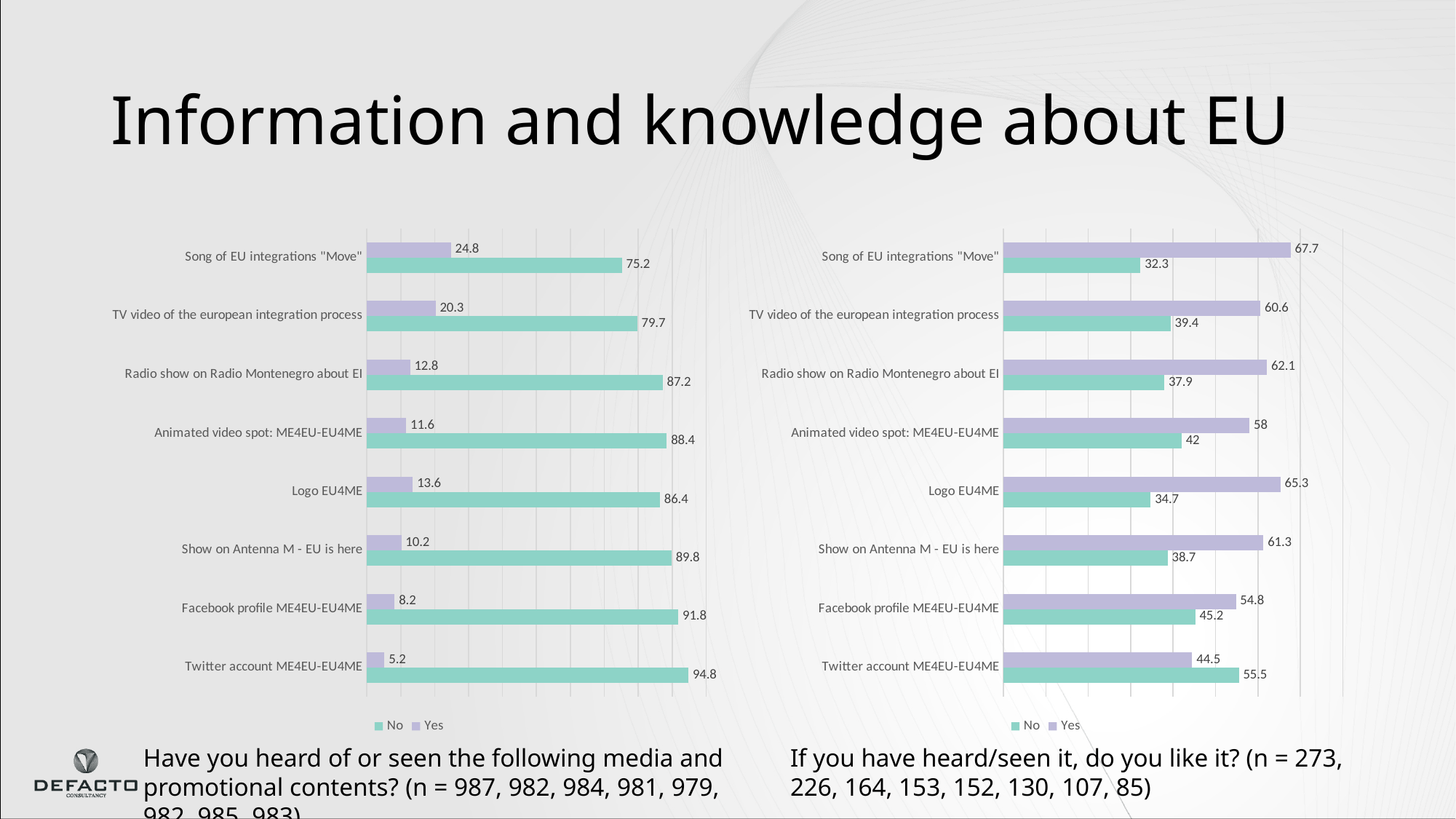
In the right chart, which is larger for Twitter account ME4EU-EU4ME: the 'Yes' value or the 'No' value? No In the left chart, which category has the highest 'Yes' value? Song of EU integrations "Move" In the right chart, what is the 'No' value for Animated video spot: ME4EU-EU4ME? 42 In the left chart, what is the difference between the 'No' and 'Yes' values for Facebook profile ME4EU-EU4ME? 83.6 In the right chart, what is the 'Yes' value for Logo EU4ME? 65.3 What type of chart is the left chart? Bar chart What are the two legend entries in the right chart? No and Yes In the right chart, which category has the lowest 'Yes' value? Twitter account ME4EU-EU4ME How many series does the legend of the right chart list? 2 How many categories are shown in the left chart? 8 In the left chart, what is the 'No' value for Twitter account ME4EU-EU4ME? 94.8 In the left chart, what is the 'Yes' value for Song of EU integrations "Move"? 24.8